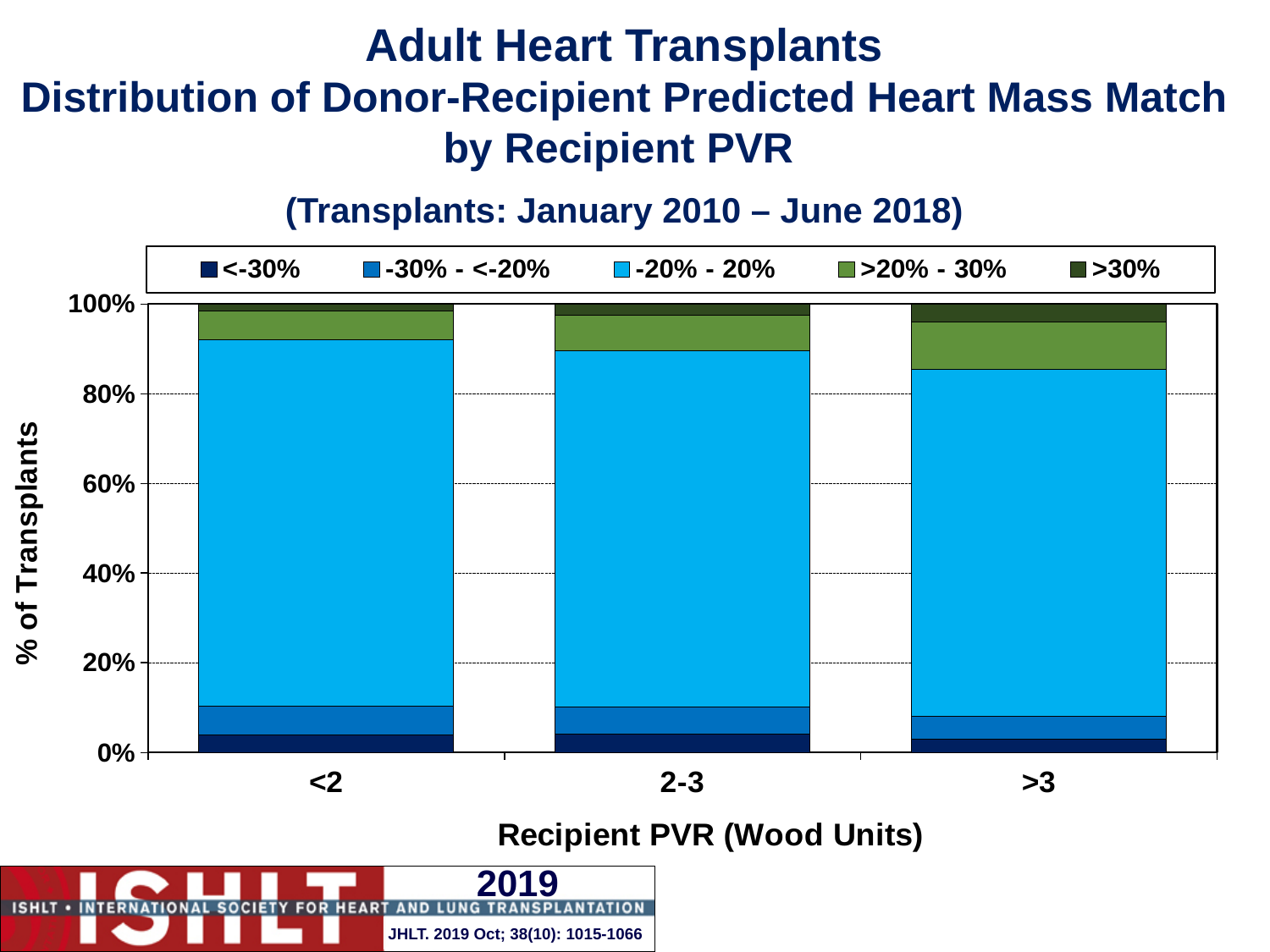
Which recipient PVR category has the smallest >20% - 30% segment? <2 How many recipient PVR categories are shown on the x axis? 3 In the >3 bar, is the top of the -20% - 20% segment greater or less than 80%? greater What is the total height of the stacked bar for the 2-3 category? 100% What is the label of the x axis? Recipient PVR (Wood Units) What is the label of the y axis? % of Transplants What kind of chart is shown on the slide? Stacked bar chart Is the -30% - <-20% segment larger for the 2-3 category or the >3 category? 2-3 Is the >30% segment larger for the >3 category or the <2 category? >3 How many series does the legend list? 5 Does the share of the >30% segment rise or fall moving from <2 to >3 along the x axis? Rise Which recipient PVR category has the largest >30% segment? >3